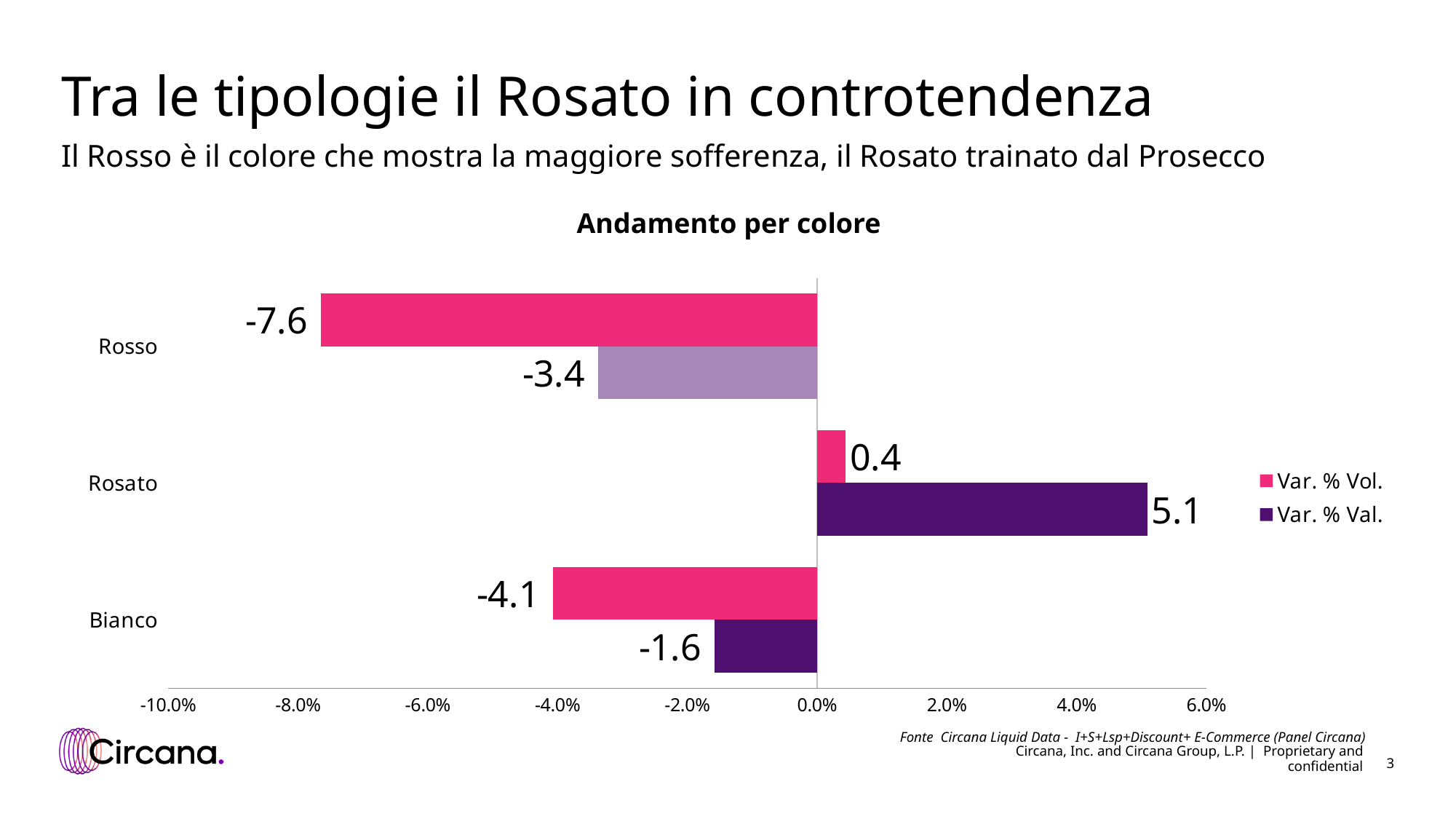
What is the Var. % Val. value for Rosato? 5.1 What is the title of the chart? Andamento per colore How many categories are shown on the chart? 3 What kind of chart is shown on the slide? Bar chart Which category has the lowest Var. % Vol. value? Rosso What is the difference between the Var. % Val. and Var. % Vol. values for Rosato? 4.7 Which category has the highest Var. % Val. value? Rosato What is the Var. % Val. value for Rosso? -3.4 Which is larger for Bianco, the Var. % Vol. value or the Var. % Val. value? Var. % Val. What is the Var. % Vol. value for Rosso? -7.6 What is the Var. % Vol. value for Bianco? -4.1 How many series does the legend list? 2